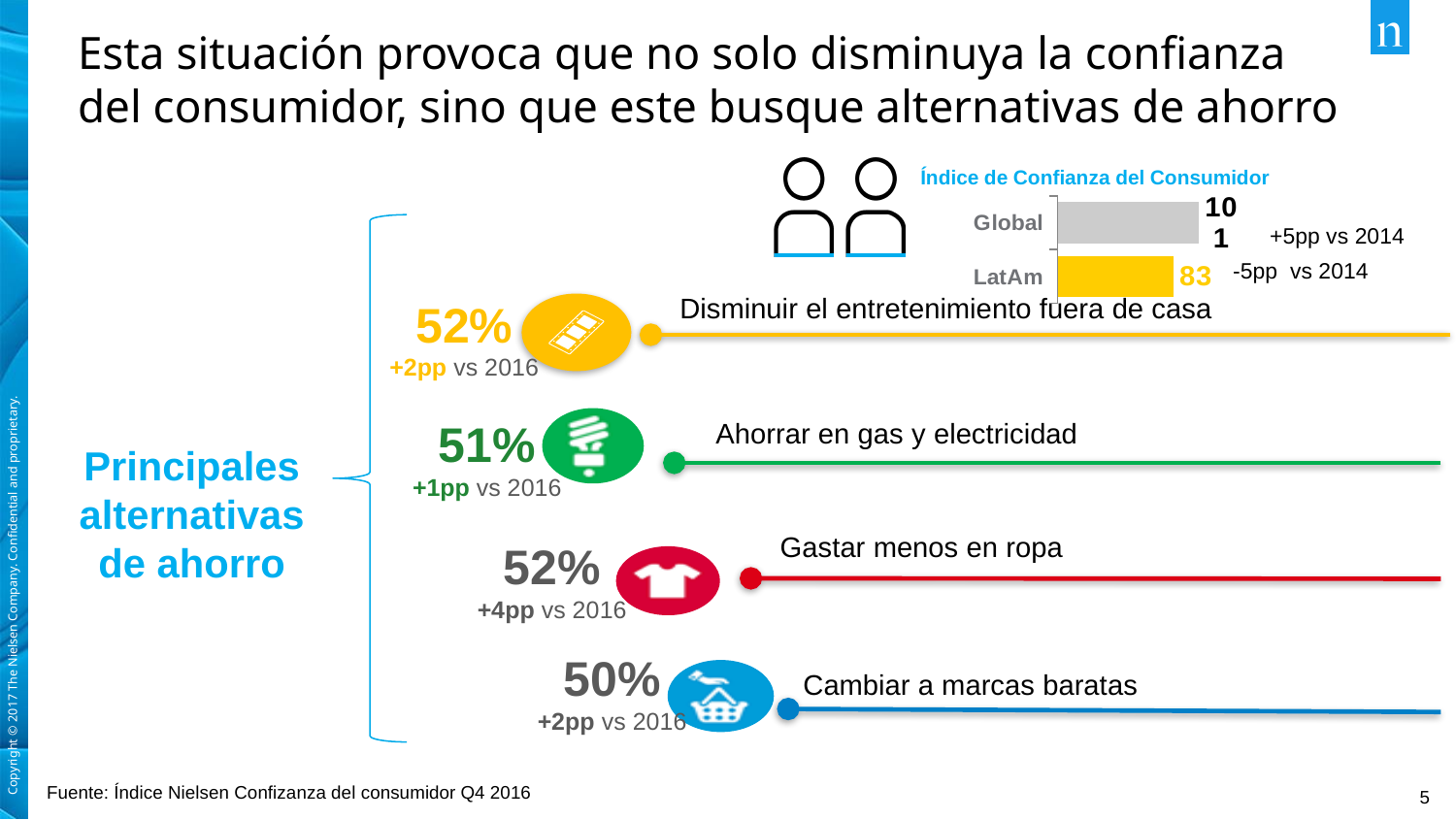
In the Índice de Confianza del Consumidor chart, what change versus 2014 is noted next to the LatAm bar? -5pp vs 2014 In the Índice de Confianza del Consumidor chart, which category has the higher value? Global In the Índice de Confianza del Consumidor chart, what change versus 2014 is noted next to the Global bar? +5pp vs 2014 In the Índice de Confianza del Consumidor chart, is the value for Global larger or smaller than the value for LatAm? larger In the Índice de Confianza del Consumidor chart, what is the difference between the Global and LatAm values? 18 How many categories are shown in the Índice de Confianza del Consumidor chart? 2 In the Índice de Confianza del Consumidor chart, what is the value for Global? 101 In the Índice de Confianza del Consumidor chart, what is the value for LatAm? 83 What type of chart is the Índice de Confianza del Consumidor chart? bar chart What is the title of the bar chart on the slide? Índice de Confianza del Consumidor In the Índice de Confianza del Consumidor chart, which category has the lower value? LatAm